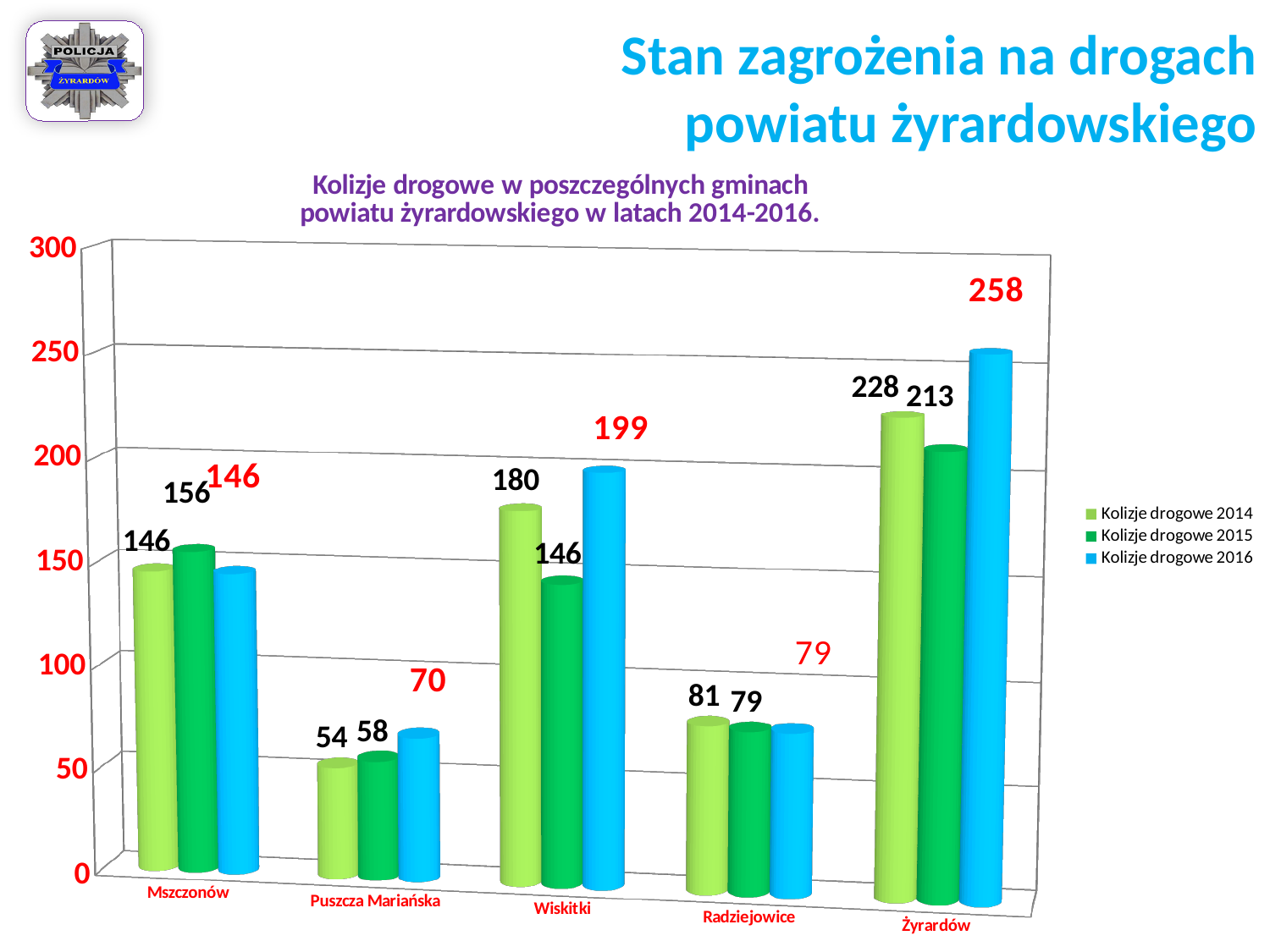
Is the value for Kolizje drogowe 2016 in Radziejowice greater or less than 100? less How many gminas (categories) are shown on the x axis? 5 What type of chart is shown on the slide? bar chart What is the value for Kolizje drogowe 2015 in Wiskitki? 146 Which gmina has the lowest value for Kolizje drogowe 2016? Puszcza Mariańska How many series does the legend list? 3 What is the value for Kolizje drogowe 2016 in Żyrardów? 258 What is the difference between Kolizje drogowe 2016 and Kolizje drogowe 2014 in Żyrardów? 30 What is the value for Kolizje drogowe 2014 in Puszcza Mariańska? 54 Which gmina has the highest value for Kolizje drogowe 2014? Żyrardów What is the title of the chart? Kolizje drogowe w poszczególnych gminach powiatu żyrardowskiego w latach 2014-2016. Which is larger in Wiskitki: Kolizje drogowe 2014 or Kolizje drogowe 2015? Kolizje drogowe 2014